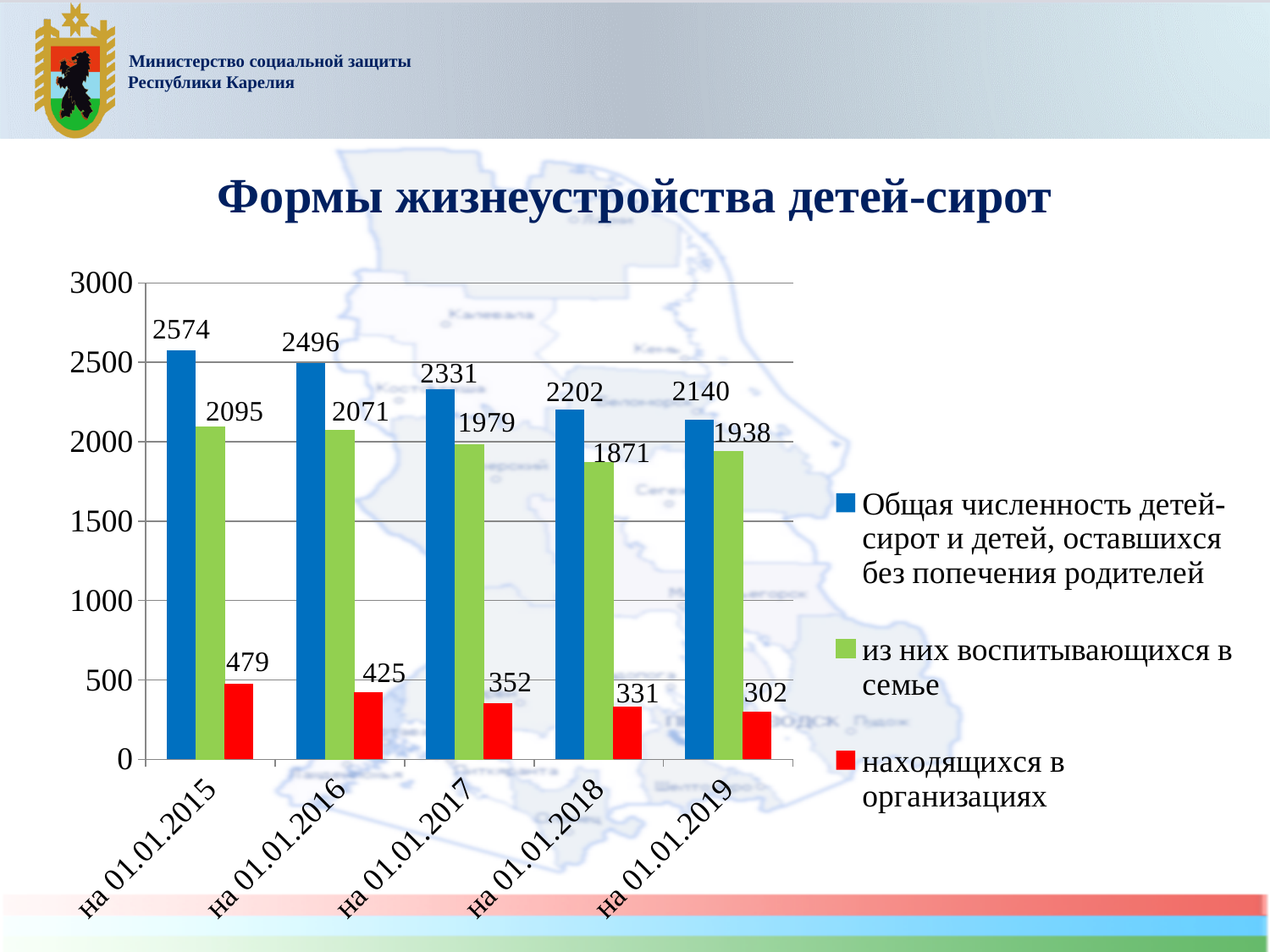
How many children were in organisations (находящихся в организациях) on 01.01.2017? 352 What is the total number of orphans and children without parental care (Общая численность) on 01.01.2015? 2574 On which date is the total number of orphans and children without parental care the highest? на 01.01.2015 How many children were being raised in families (воспитывающихся в семье) on 01.01.2019? 1938 Does the total number of orphans and children without parental care rise or fall from 01.01.2015 to 01.01.2019? fall What is the difference between the total number of orphans on 01.01.2015 and on 01.01.2019? 434 How many series does the legend list? 3 What kind of chart is shown on the slide? bar chart On which date is the number of children in organisations the lowest? на 01.01.2019 How many dates (categories) are shown on the x axis? 5 Which is larger: the number of children raised in families on 01.01.2018 or on 01.01.2019? на 01.01.2019 What is the difference between the number of children in organisations on 01.01.2015 and on 01.01.2016? 54